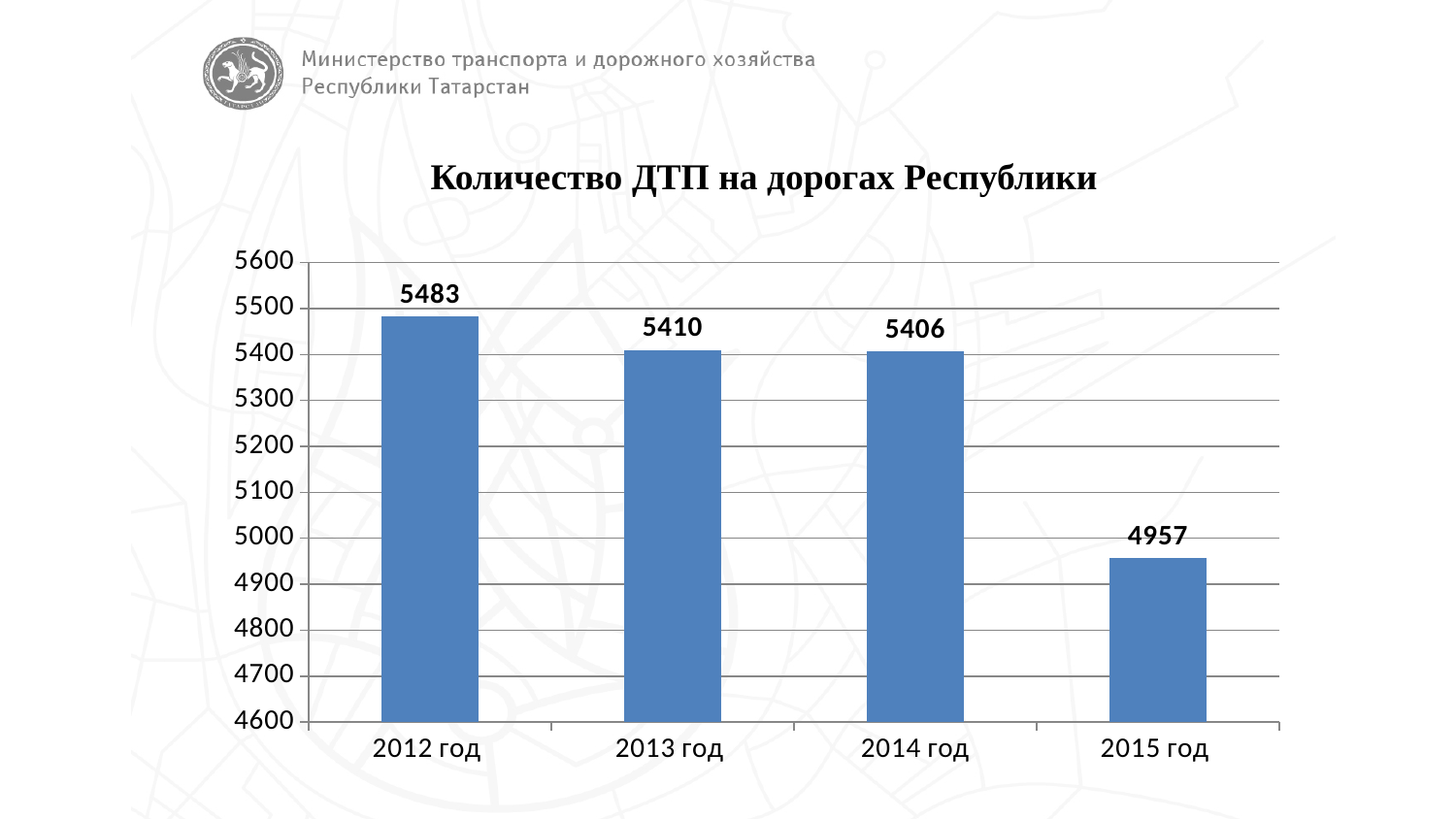
What is the value for 2015 год? 4957 What is the difference between the values for 2013 год and 2014 год? 4 What is the difference between the values for 2012 год and 2015 год? 526 What is the title of the chart? Количество ДТП на дорогах Республики What is the value for 2012 год? 5483 Which year has the lowest value? 2015 год Is the value for 2015 год greater or less than 5000? less Which is larger, the value for 2012 год or the value for 2014 год? 2012 год Which year has the highest value? 2012 год How many years are shown on the chart? 4 What kind of chart is shown on the slide? bar chart What is the value for 2013 год? 5410